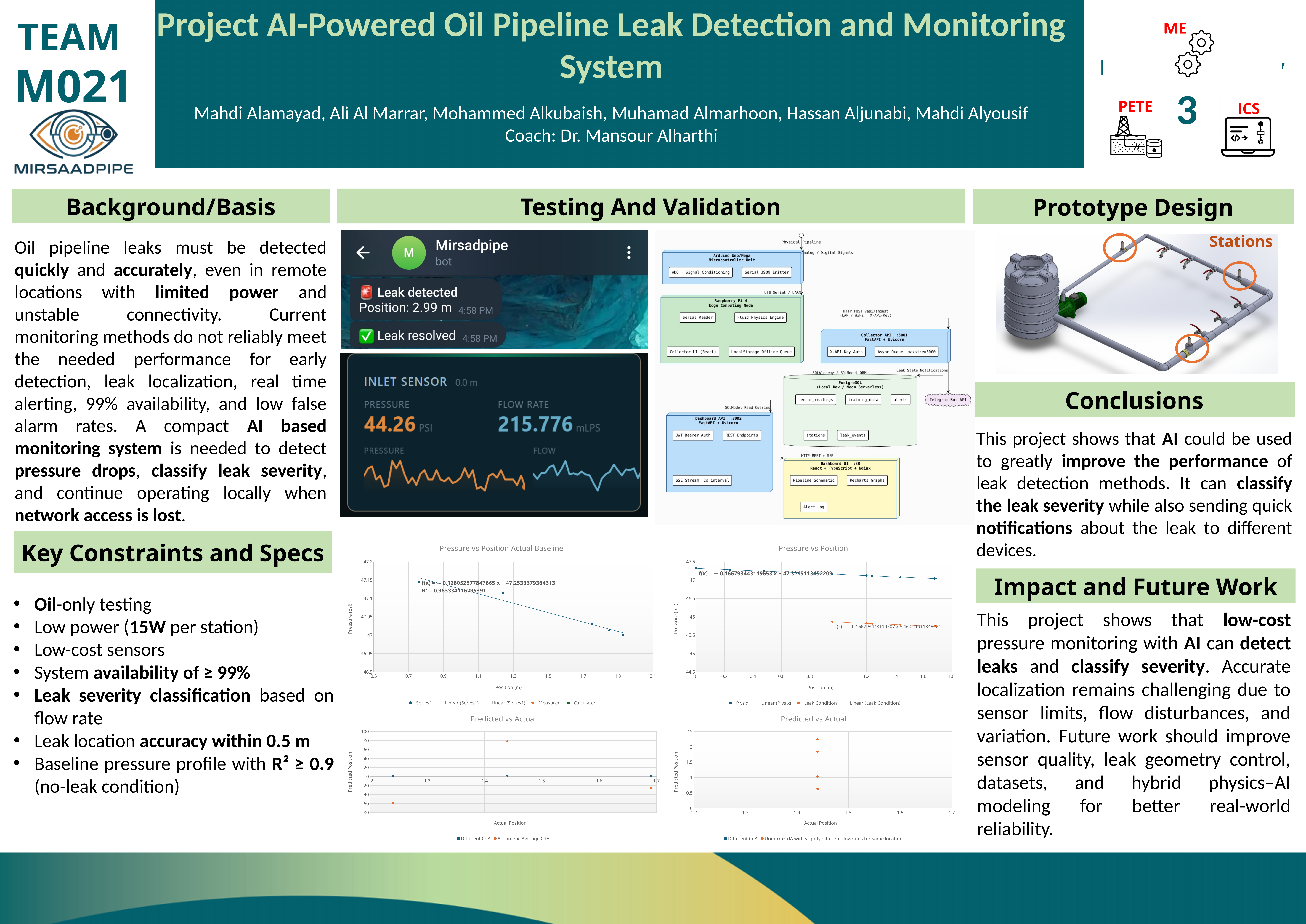
In the left 'Predicted vs Actual' chart, how many series does the legend list? 2 In the 'Pressure vs Position' chart, are the Leak Condition pressure values greater or less than 46? less In the 'Pressure vs Position Actual Baseline' chart, how many entries does the legend list? 5 In the 'Pressure vs Position' chart, does the P vs x series rise or fall as position increases? fall In the right 'Predicted vs Actual' chart, is the highest orange point greater or less than 2? greater In the 'Pressure vs Position Actual Baseline' chart, does pressure rise or fall as position increases? fall What are the legend entries of the right 'Predicted vs Actual' chart? Different CdA; Uniform CdA with slightly different flowrates for same location What R² value is printed on the 'Pressure vs Position Actual Baseline' chart? R² = 0.963334116295391 In the 'Pressure vs Position' chart, how many entries does the legend list? 4 In the left 'Predicted vs Actual' chart, is the highest Arithmetic Average CdA point greater or less than 60? greater What kind of chart is the 'Pressure vs Position Actual Baseline' chart? scatter chart